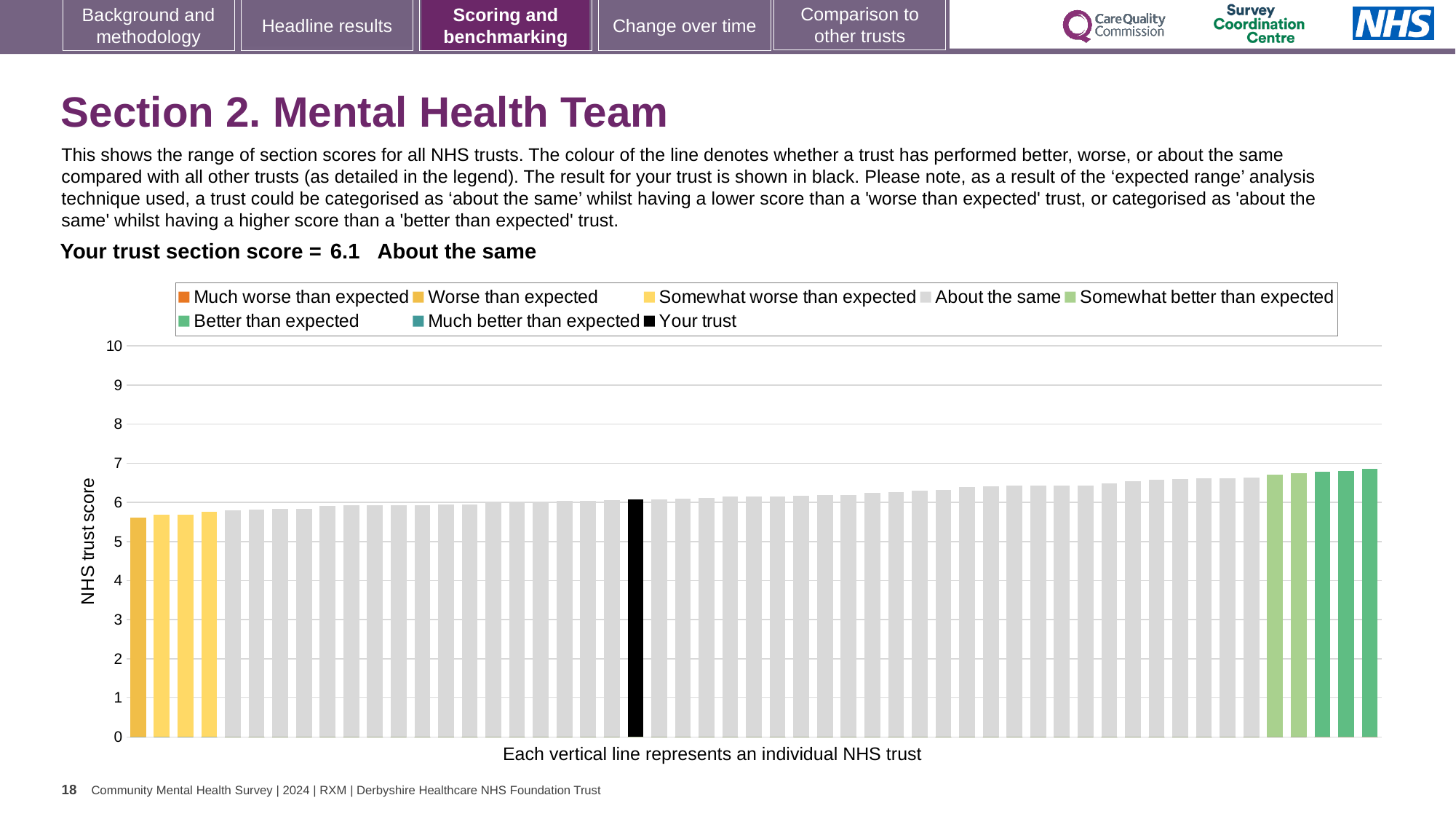
What is the highest value shown on the vertical axis? 10 What colour is the bar representing your trust? black What is the label on the vertical axis of the chart? NHS trust score How many entries does the chart legend list? 8 What is the section score for your trust shown on the slide? 6.1 Do the bar values rise or fall from left to right across the chart? rise What type of chart is shown on the slide? bar chart How many bars are coloured yellow (worse or somewhat worse than expected) in the chart? 4 How is your trust categorised compared with other trusts, according to the text above the chart? About the same Is the value of the highest bar in the chart greater or less than 7? less Is the value of the lowest bar in the chart greater or less than 5? greater